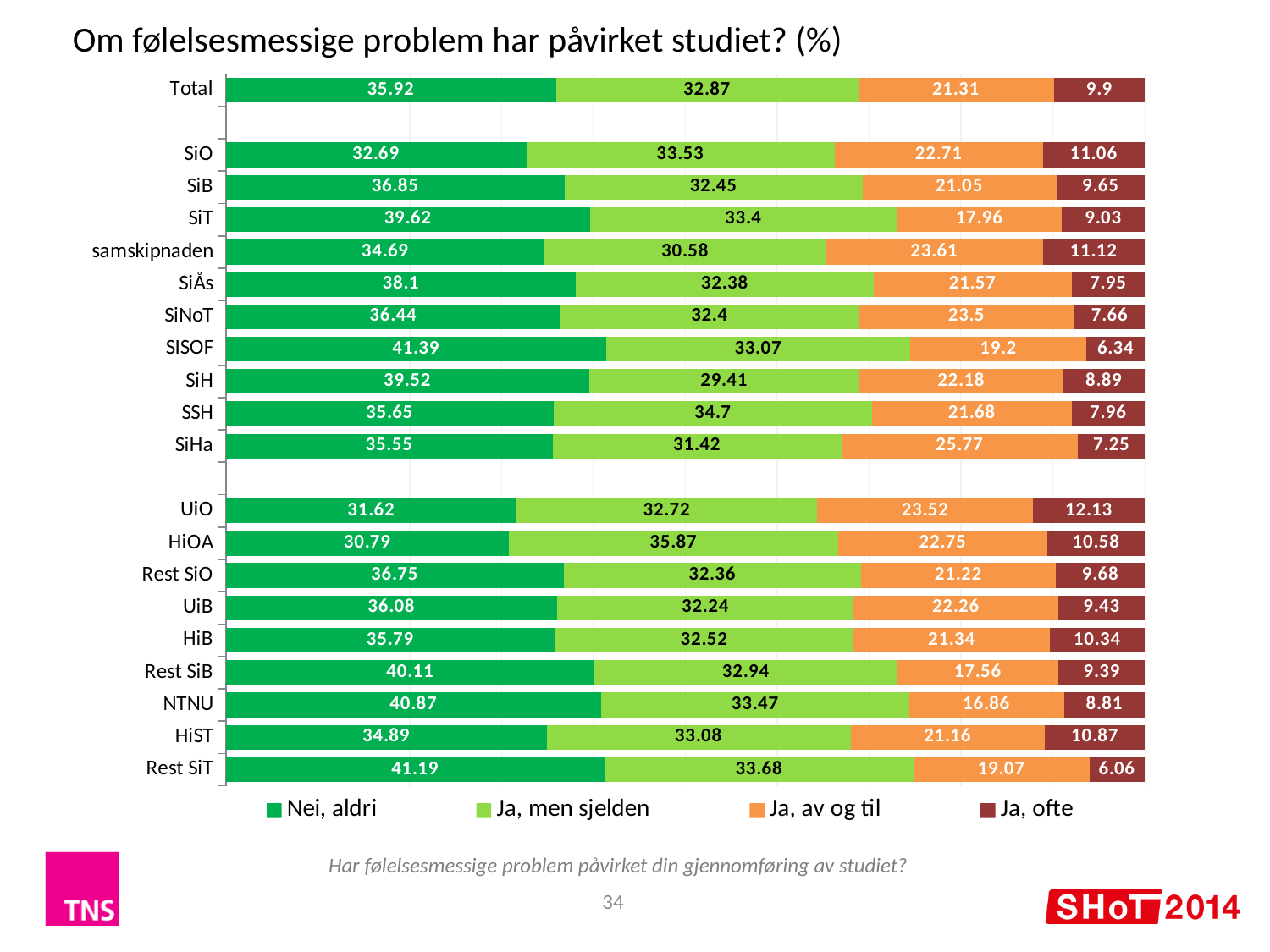
How many series does the legend list? 4 What is the value of "Nei, aldri" for NTNU? 40.87 What is the value of "Ja, ofte" for UiO? 12.13 What is the value of "Ja, av og til" for SiHa? 25.77 Which category has the lowest value for "Ja, av og til"? NTNU Which category has the highest value for "Ja, ofte"? UiO Which category has the lowest value for "Ja, ofte"? Rest SiT What is the difference between "Nei, aldri" and "Ja, ofte" for Total? 26.02 Which has the larger value for "Ja, men sjelden", HiOA or UiO? HiOA What kind of chart is shown on the slide? Stacked bar chart What is the title of the chart? Om følelsesmessige problem har påvirket studiet? (%) How many categories are shown on the y axis? 20